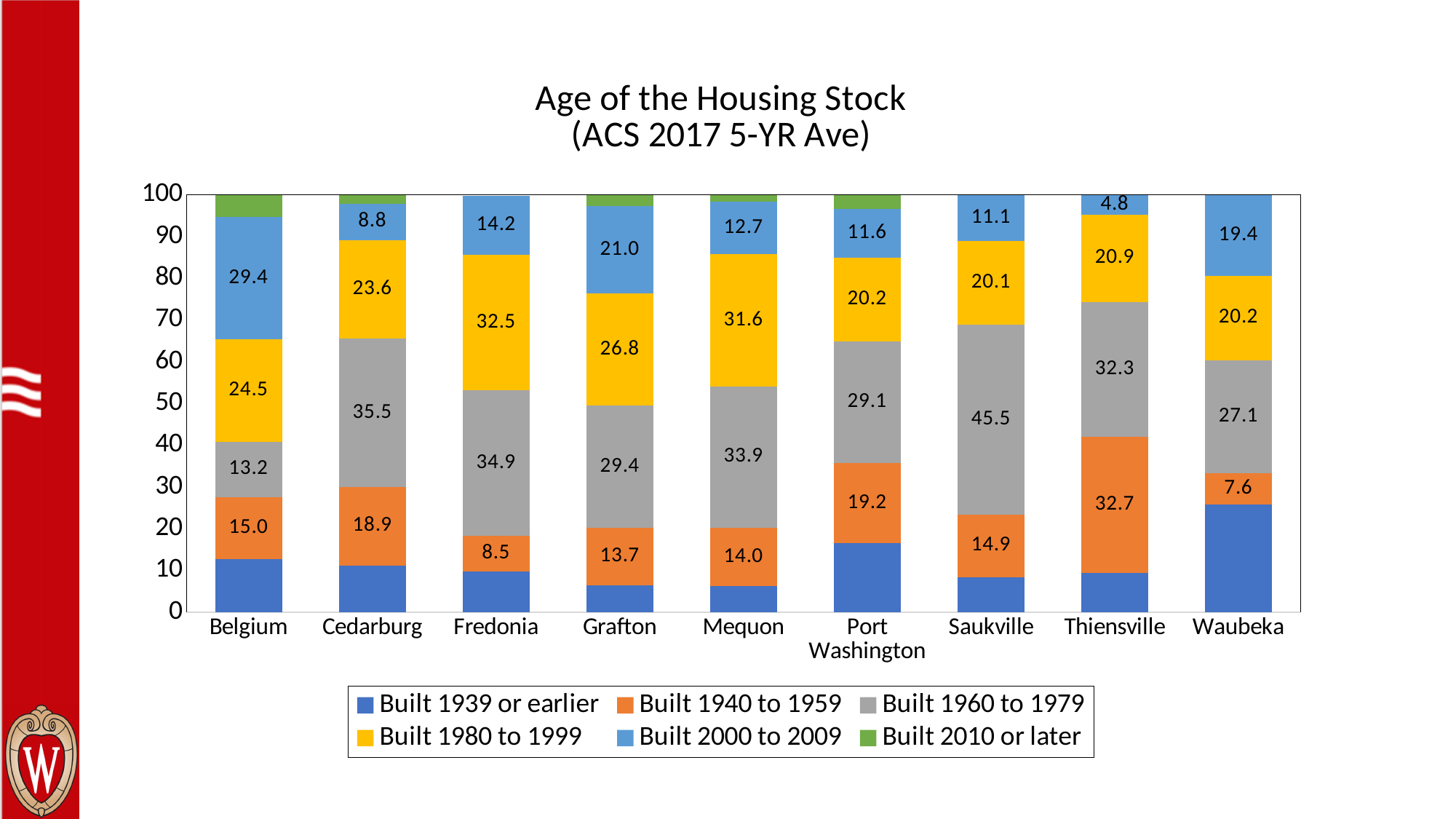
What is the value for Built 1960 to 1979 in Saukville? 45.5 What kind of chart is shown on the slide? stacked bar chart Is the value for Built 1939 or earlier in Waubeka greater or less than 20? greater What is the title of the chart? Age of the Housing Stock (ACS 2017 5-YR Ave) What is the value for Built 2000 to 2009 in Grafton? 21.0 How many series does the legend list? 6 What is the value for Built 1940 to 1959 in Thiensville? 32.7 Which community has the lowest value for Built 2000 to 2009? Thiensville What is the difference between the Built 1980 to 1999 values for Fredonia and Mequon? 0.9 Which community has the highest value for Built 1960 to 1979? Saukville How many communities are shown along the x axis? 9 Which is larger, the Built 1940 to 1959 value for Port Washington or for Cedarburg? Port Washington